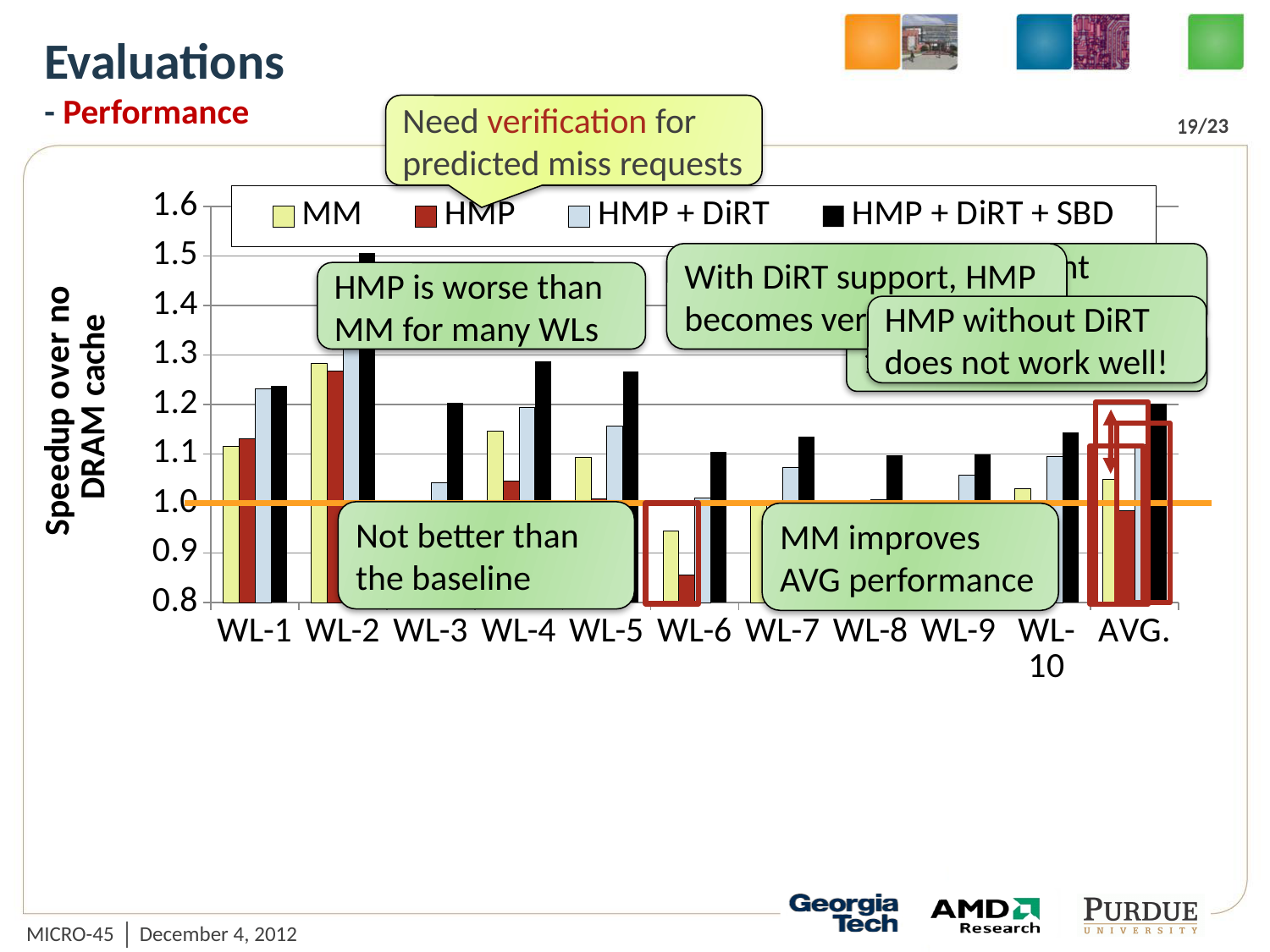
For WL-6, which is larger: the MM value or the HMP value? MM Is the HMP value for WL-6 greater or less than 0.9? less How many categories are shown along the x axis of the chart? 11 What kind of chart is shown on the slide? bar chart Which series is drawn in black in the chart? HMP + DiRT + SBD Is the HMP + DiRT + SBD value for AVG. greater or less than 1.1? greater Is the MM value for WL-6 greater or less than 1.0? less How many series does the chart's legend list? 4 What is the label of the y axis of the chart? Speedup over no DRAM cache For which category is the HMP + DiRT + SBD value highest? WL-2